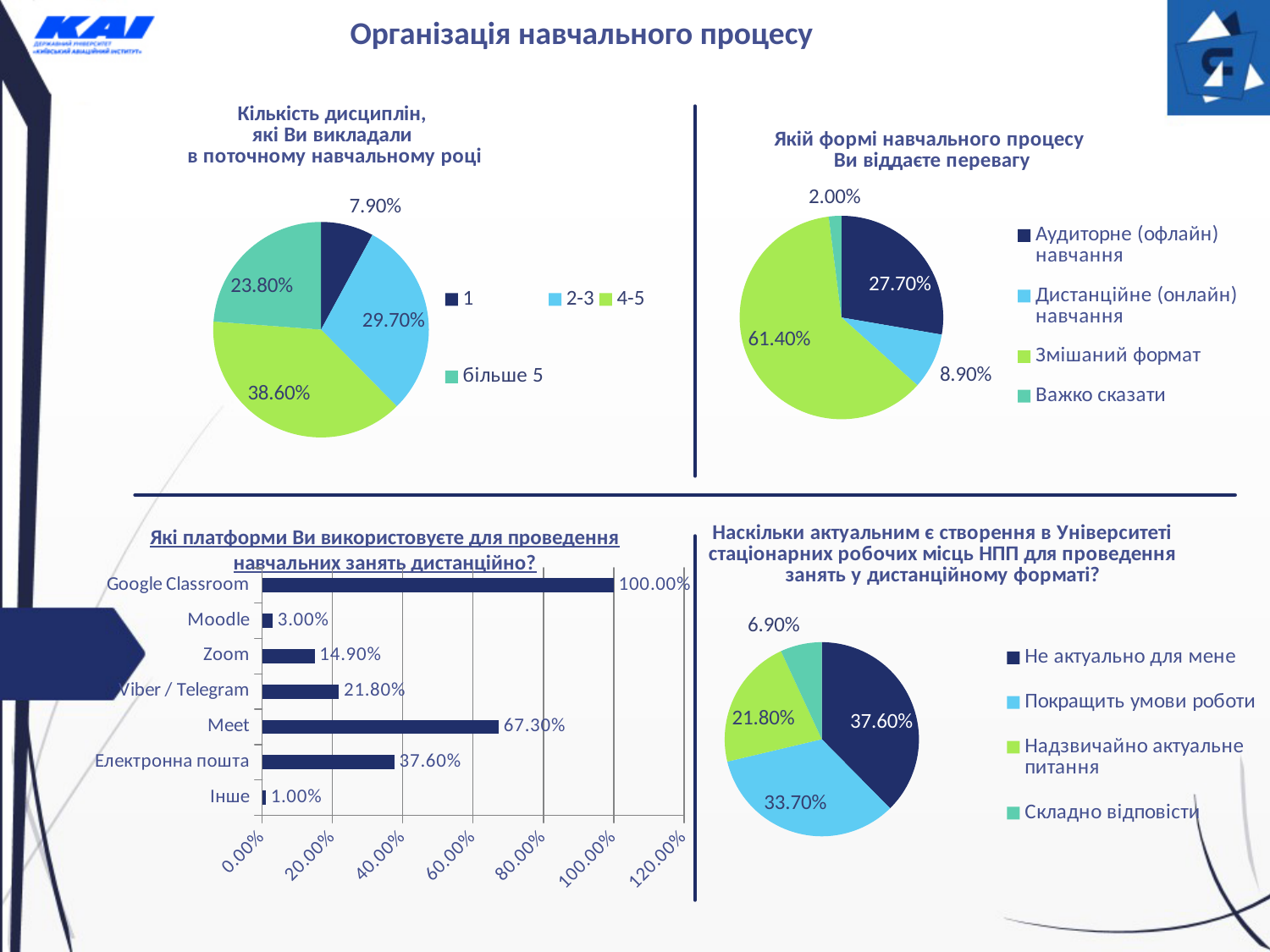
What kind of chart is the bottom-left chart (Які платформи Ви використовуєте для проведення навчальних занять дистанційно?)? Bar chart In the top-right pie chart (Якій формі навчального процесу Ви віддаєте перевагу), what share is shown for 'Змішаний формат'? 61.40% In the bottom-left chart (Які платформи Ви використовуєте), how many platforms are listed? 7 In the top-left pie chart (Кількість дисциплін, які Ви викладали в поточному навчальному році), what share is shown for the category '4-5'? 38.60% In the bottom-right pie chart (Наскільки актуальним є створення стаціонарних робочих місць НПП), which is larger: 'Не актуально для мене' or 'Надзвичайно актуальне питання'? Не актуально для мене In the top-left pie chart (Кількість дисциплін), which category has the smallest share? 1 In the top-right pie chart (Якій формі навчального процесу Ви віддаєте перевагу), which category has the largest share? Змішаний формат In the bottom-left chart (Які платформи Ви використовуєте для проведення навчальних занять дистанційно?), what value is shown for Meet? 67.30% In the bottom-left chart (Які платформи Ви використовуєте), which platform has the lowest value? Інше In the bottom-right pie chart (Наскільки актуальним є створення в Університеті стаціонарних робочих місць НПП), what share is shown for 'Покращить умови роботи'? 33.70% In the top-left pie chart (Кількість дисциплін), what is the difference between the shares for '2-3' and 'більше 5'? 5.90% In the top-right pie chart (Якій формі навчального процесу), how many categories does the legend list? 4